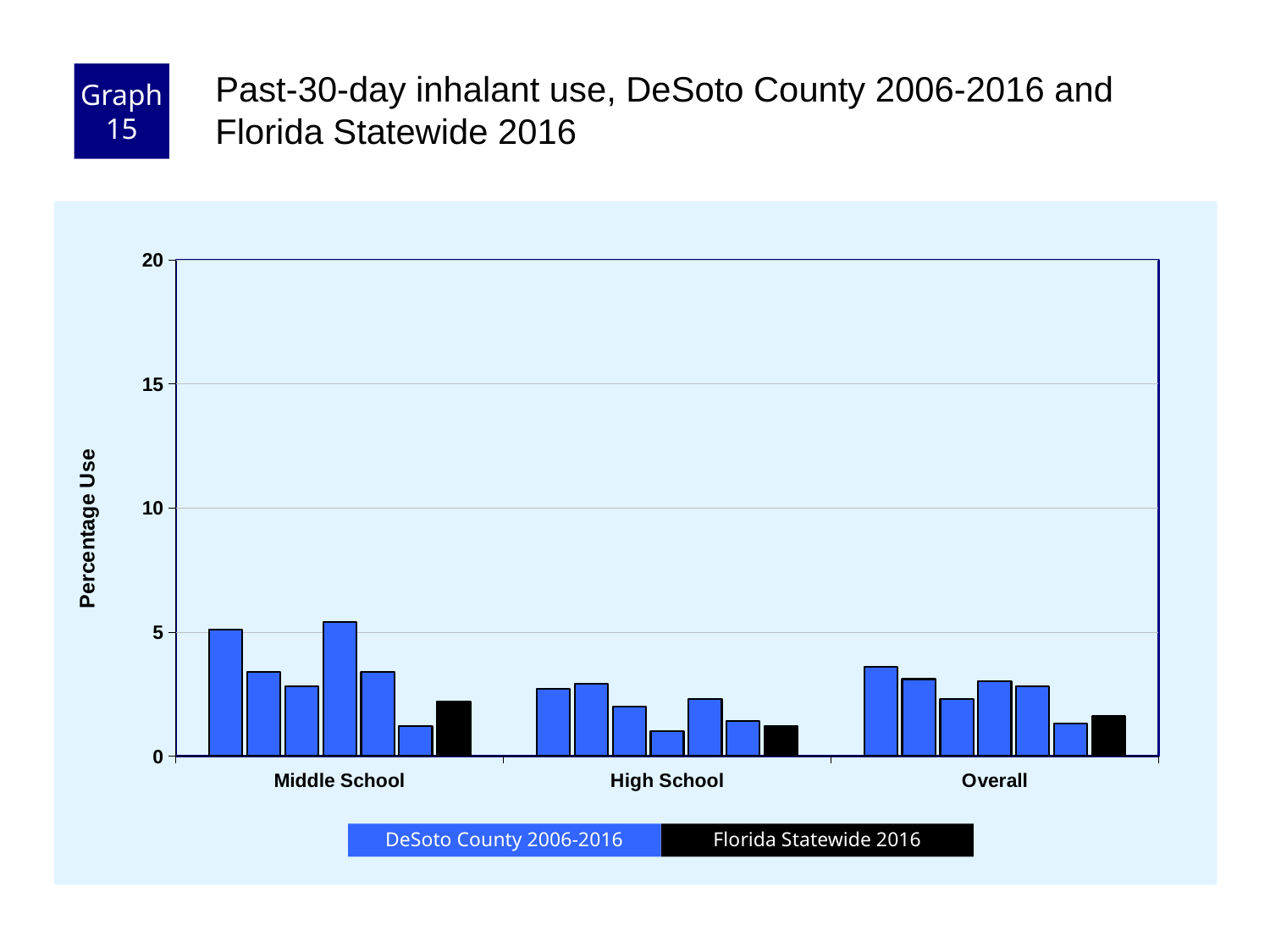
Is the Florida Statewide 2016 value for Middle School greater or less than 5? less How many categories are shown on the x axis of the chart? 3 How many series does the chart legend list? 2 Which is larger, the Florida Statewide 2016 value for Middle School or for High School? Middle School What kind of chart is shown on the slide? bar chart What is the title of the chart? Past-30-day inhalant use, DeSoto County 2006-2016 and Florida Statewide 2016 Which category has the highest Florida Statewide 2016 value? Middle School Are any of the bars in the chart greater than 10? No Which category has the lowest Florida Statewide 2016 value? High School Is the Florida Statewide 2016 value for High School greater or less than 5? less What is the label on the vertical axis of the chart? Percentage Use